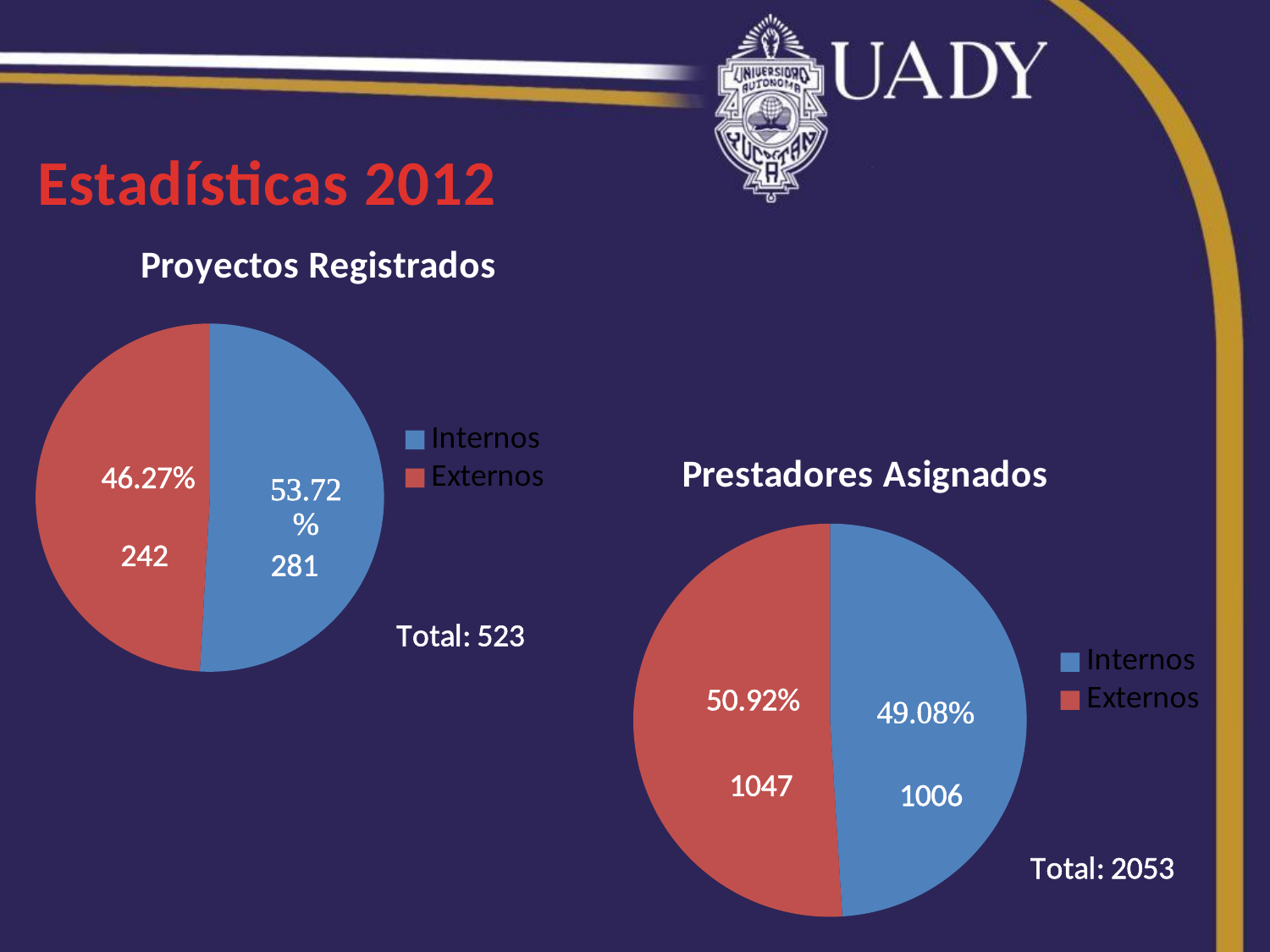
In the 'Prestadores Asignados' chart, which category is the smallest? Internos In the 'Proyectos Registrados' chart, what is the difference between Internos and Externos? 39 How many series does the legend of the 'Proyectos Registrados' chart list? 2 In the 'Prestadores Asignados' chart, what is the difference between Externos and Internos? 41 In the 'Prestadores Asignados' chart, what percentage share does Internos have? 49.08% In the 'Prestadores Asignados' chart, what is the value for Internos? 1006 What kind of chart is the 'Prestadores Asignados' chart? Pie chart In the 'Prestadores Asignados' chart, what is the value for Externos? 1047 In the 'Proyectos Registrados' chart, what percentage share does Externos have? 46.27% In the 'Proyectos Registrados' chart, what is the value for Externos? 242 In the 'Proyectos Registrados' chart, which category is the largest? Internos In the 'Proyectos Registrados' chart, what is the value for Internos? 281